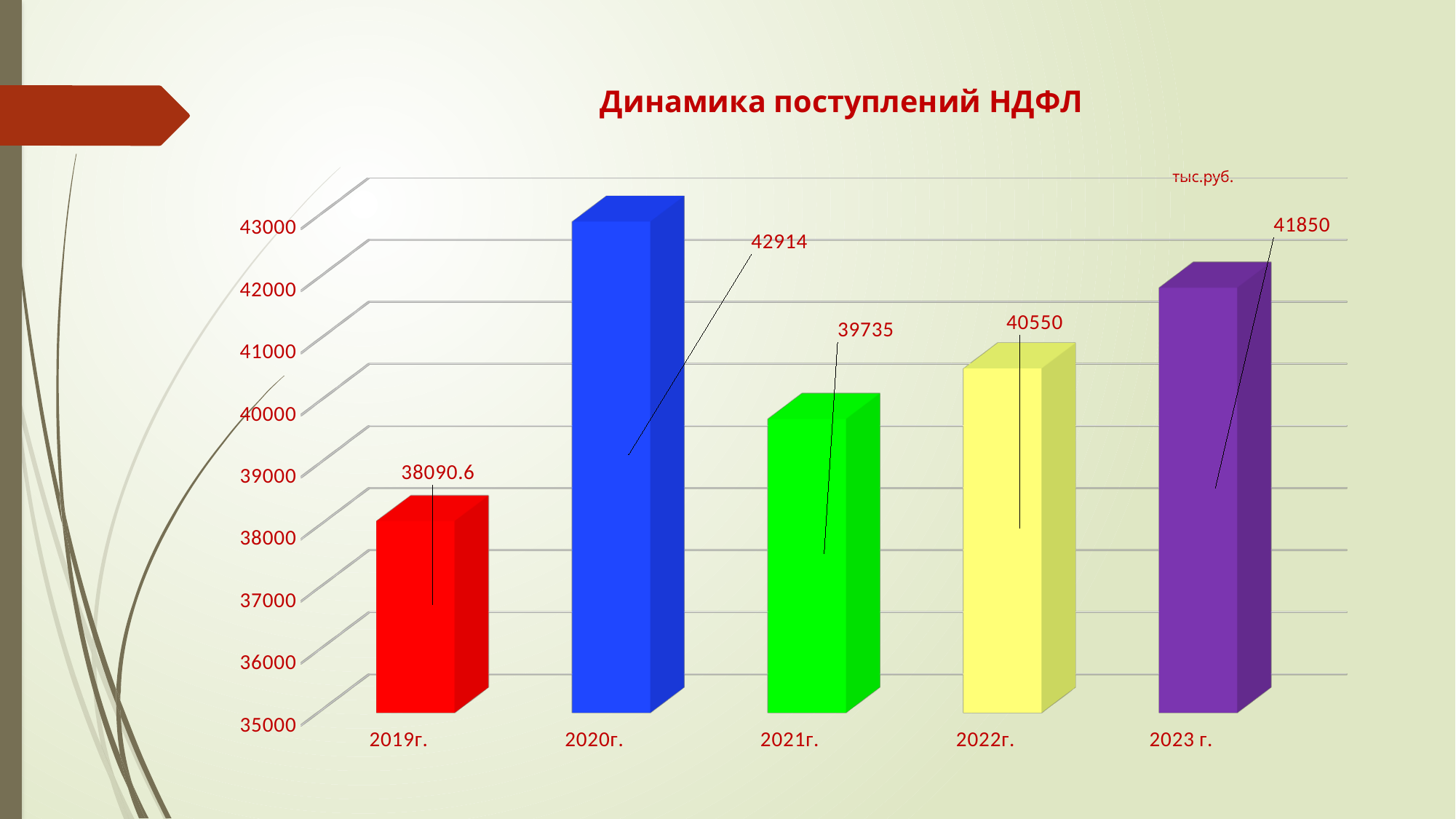
Which year has the highest value? 2020г. What kind of chart is shown on the slide? bar chart Which year has the lowest value? 2019г. What is the value for 2022г.? 40550 How many years are shown on the chart? 5 What is the value for 2020г.? 42914 Which is larger, the value for 2021г. or the value for 2023 г.? 2023 г. Is the value for 2021г. greater or less than 40000? less What is the difference between the values for 2020г. and 2021г.? 3179 What is the difference between the values for 2023 г. and 2022г.? 1300 What is the value for 2019г.? 38090.6 What is the title of the chart? Динамика поступлений НДФЛ